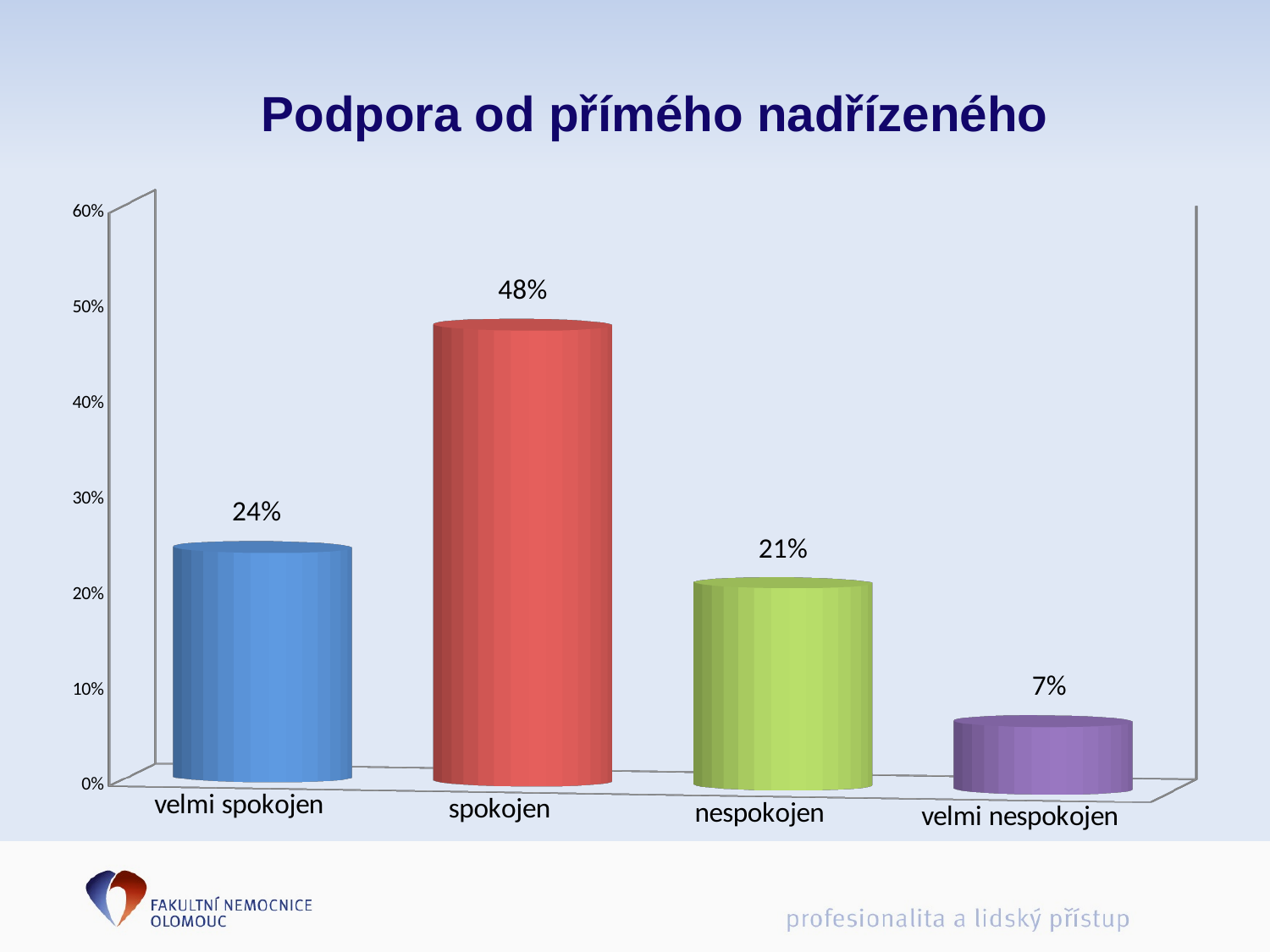
What is the title of the chart? Podpora od přímého nadřízeného What kind of chart is shown on the slide? bar chart What is the value for "nespokojen"? 21% Which category has the highest value? spokojen What is the value for "velmi spokojen"? 24% What is the value for "velmi nespokojen"? 7% Which is larger, the value for "velmi spokojen" or the value for "nespokojen"? velmi spokojen Which category has the lowest value? velmi nespokojen Is the value for "spokojen" greater or less than 40%? greater What is the difference between the values for "spokojen" and "velmi spokojen"? 24% What is the value for "spokojen"? 48% How many categories are shown on the x axis? 4